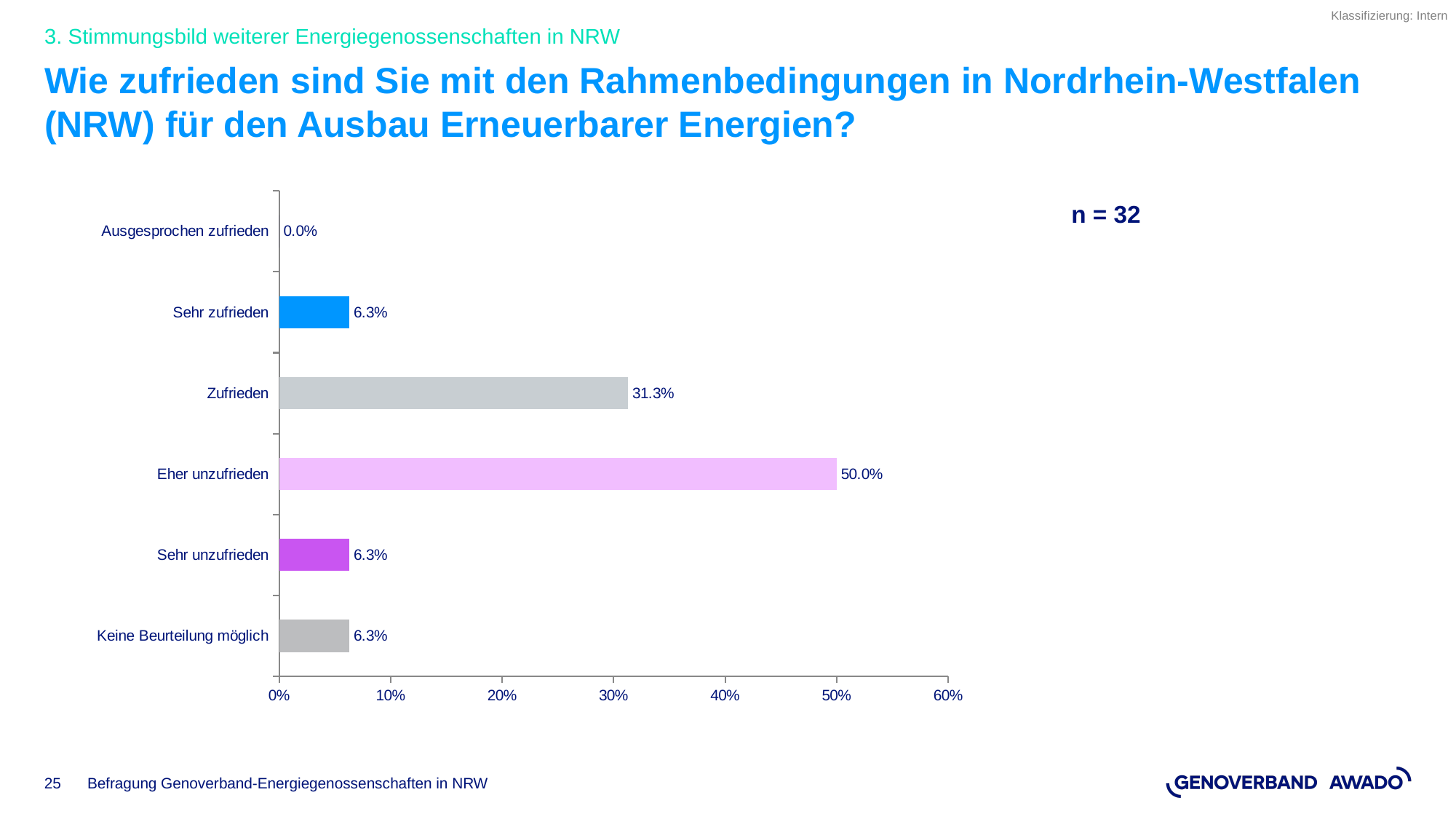
What sample size (n) is stated next to the chart? n = 32 Which category has the lowest value? Ausgesprochen zufrieden What is the difference between the values for "Eher unzufrieden" and "Zufrieden"? 18.7% Which is larger, the value for "Zufrieden" or the value for "Sehr zufrieden"? Zufrieden Which category has the highest value? Eher unzufrieden What is the value for "Eher unzufrieden"? 50.0% What kind of chart is shown on the slide? bar chart What is the value for "Ausgesprochen zufrieden"? 0.0% Is the value for "Zufrieden" greater or less than 40%? less What is the value for "Zufrieden"? 31.3% How many categories are shown in the chart? 6 What is the value for "Keine Beurteilung möglich"? 6.3%